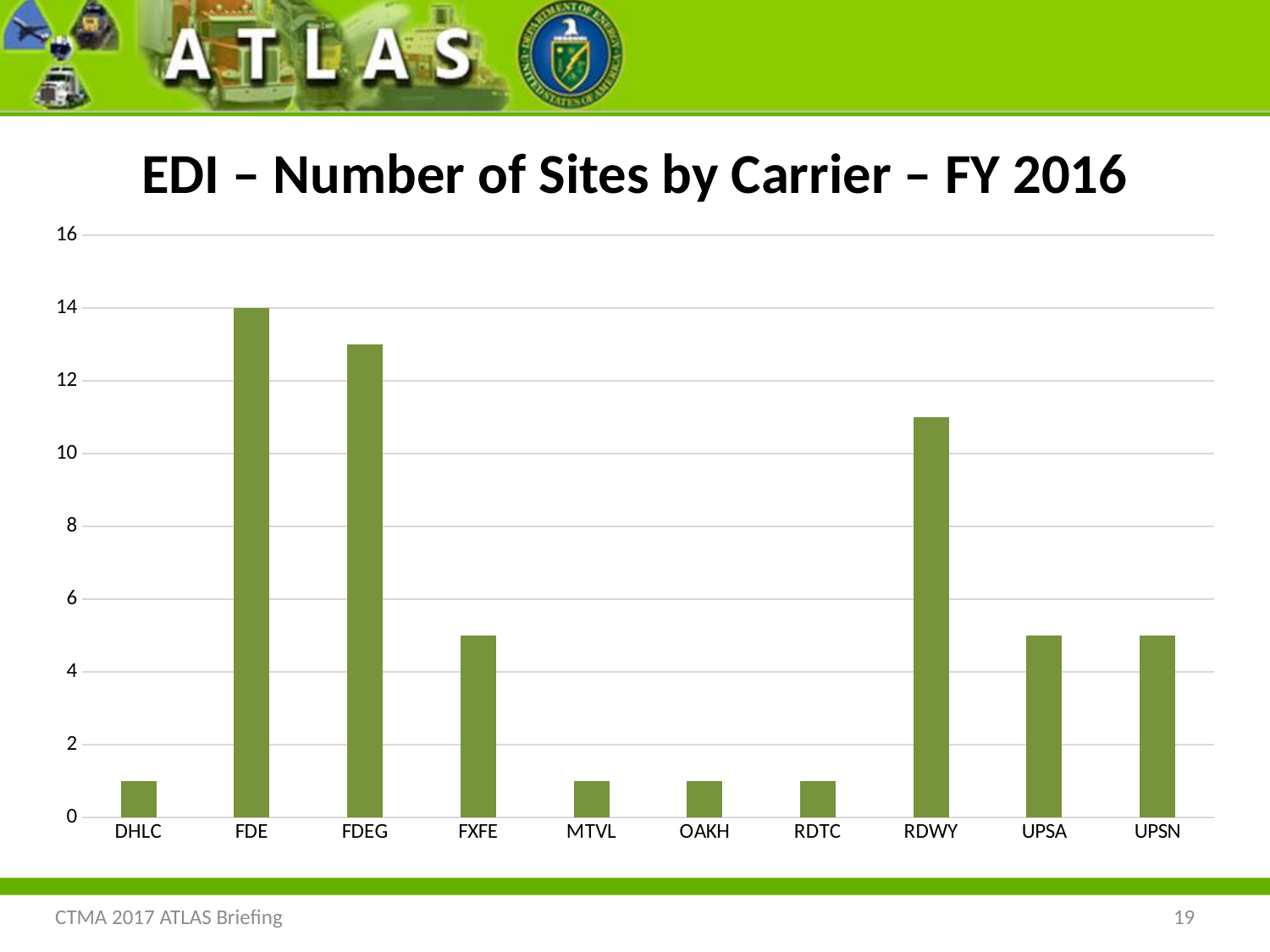
Which has more sites, FDEG or RDWY? FDEG Which carrier has the highest number of sites? FDE How many carriers are shown on the x axis of the chart? 10 What type of chart is shown on the slide? bar chart Is the value for RDWY greater or less than 10? greater What is the number of sites for FDE? 14 Is the value for DHLC greater or less than 2? less What is the title of the chart? EDI – Number of Sites by Carrier – FY 2016 Is the value for FXFE greater or less than 4? greater Which has more sites, UPSA or OAKH? UPSA